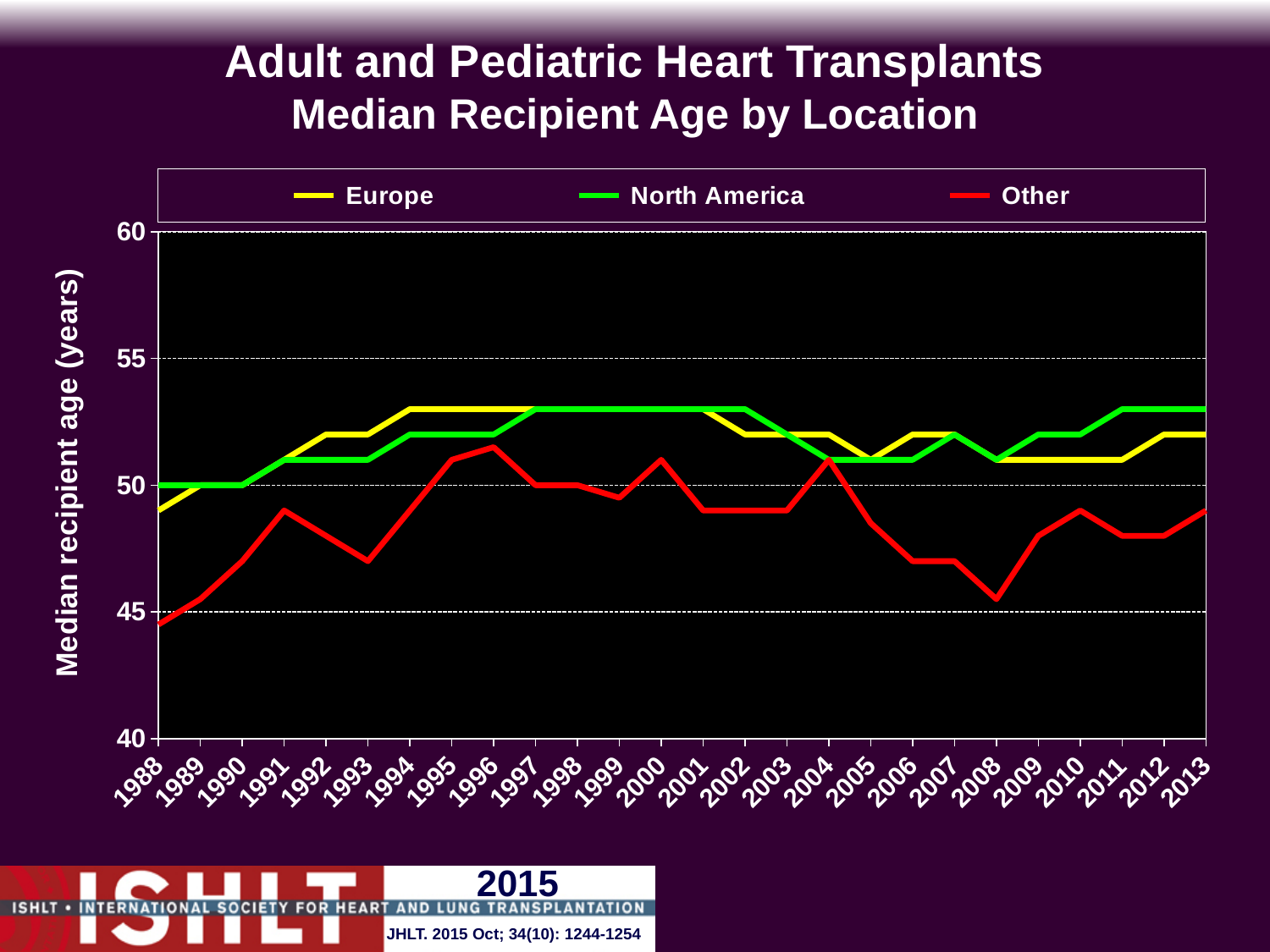
What colour is the Europe line in the legend? Yellow Is the value for Other in 1988 greater or less than 45? less Does the Other series rise or fall between 2004 and 2008? Fall What kind of chart is shown on the slide? Line chart What is the median recipient age for North America in 1988? 50 Is the value for Other in 2008 greater or less than 50? less In which year is the Other series at its lowest value? 1988 In 2013, which series has the higher median recipient age, Europe or Other? Europe In 1988, which series has the higher median recipient age, Europe or North America? North America How many years are plotted along the x axis? 26 Is the value for Europe in 2013 greater or less than 50? greater How many series does the legend list? 3